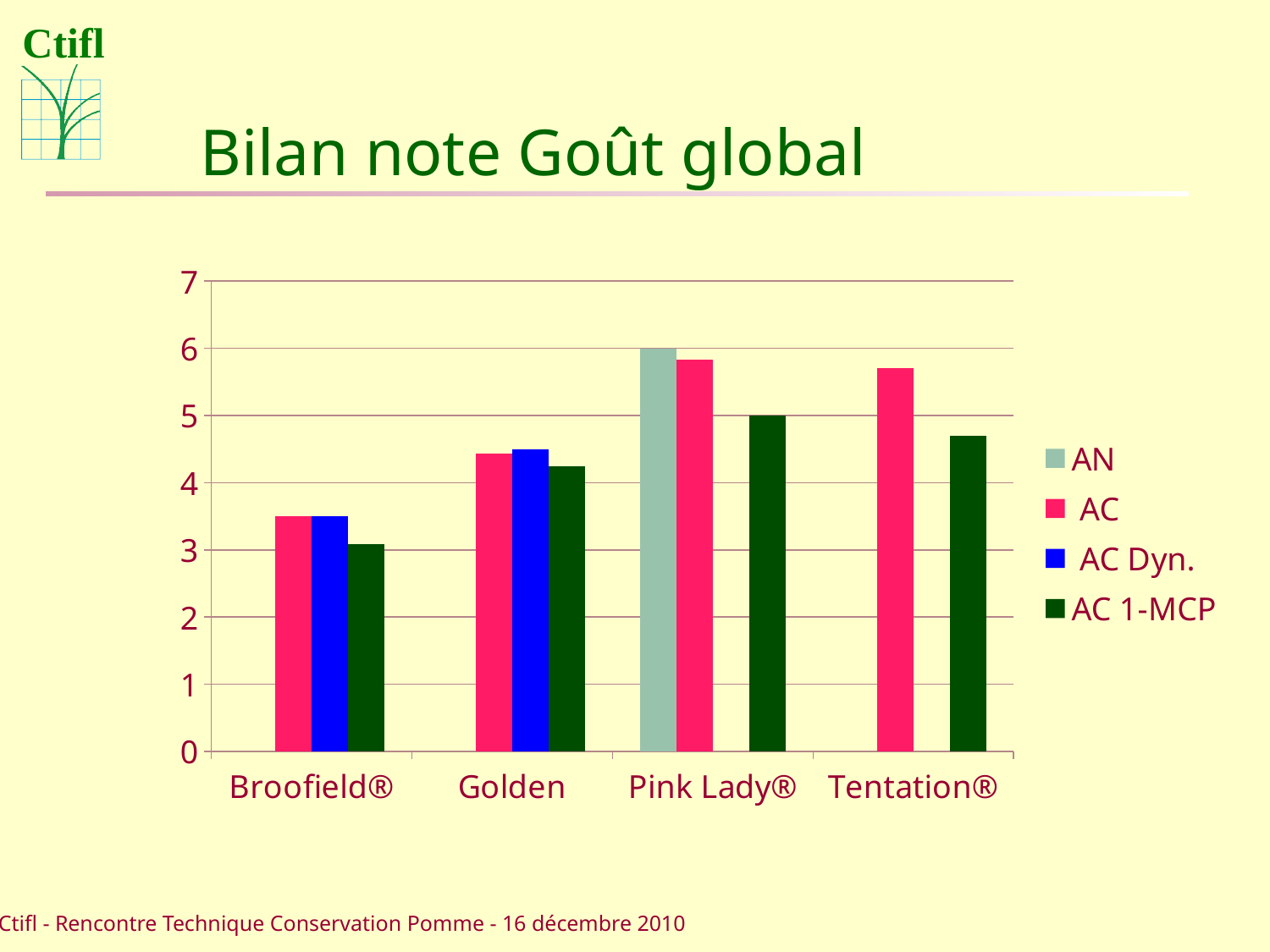
Is the AC 1-MCP value for Broofield® greater or less than 4? less What is the title of the chart? Bilan note Goût global Which series is shown in blue in the legend? AC Dyn. How many apple varieties are shown on the x axis? 4 Which variety is the only one with an AN bar? Pink Lady® Which variety has the highest AC value? Pink Lady® Which variety has the lowest AC 1-MCP value? Broofield® Is the AC value for Tentation® greater or less than 5? greater What kind of chart is shown on the slide? bar chart Is the AC value for Pink Lady® greater or less than 6? less For Tentation®, which is larger: the AC value or the AC 1-MCP value? AC How many series does the legend list? 4